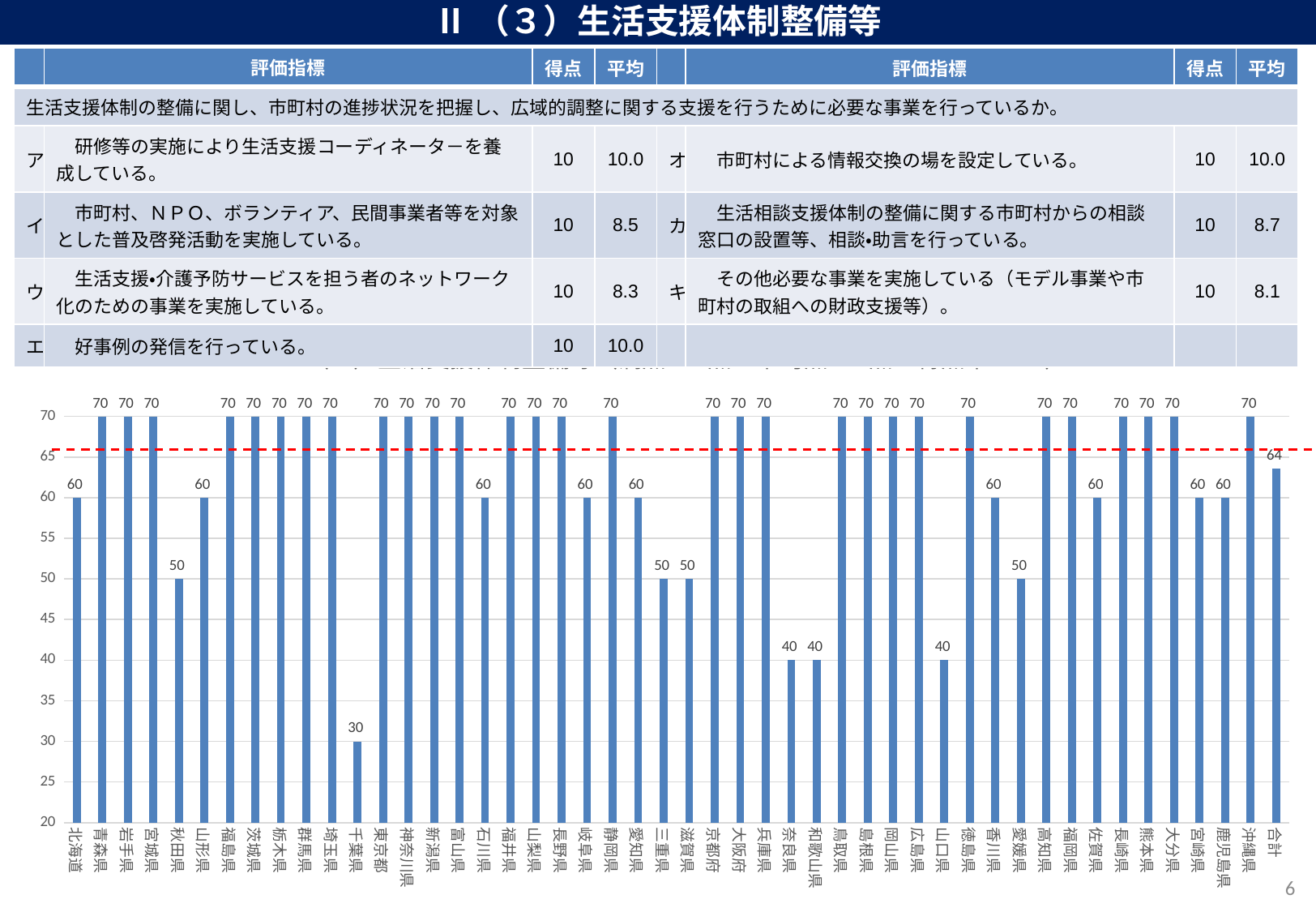
What is the difference between the values for 北海道 and 千葉県? 30 How many bars are plotted in the chart? 48 Is the value for 山口県 greater or less than 50? less Which has the larger value, 秋田県 or 山形県? 山形県 What is the value for 合計 in the bar chart? 64 What kind of chart is shown on the slide? bar chart What is the value for 奈良県 in the bar chart? 40 Which category has the lowest value in the bar chart? 千葉県 What is the value for 愛媛県 in the bar chart? 50 What is the value for 千葉県 in the bar chart? 30 What is the difference between the values for 合計 and 千葉県? 34 What is the value for 三重県 in the bar chart? 50